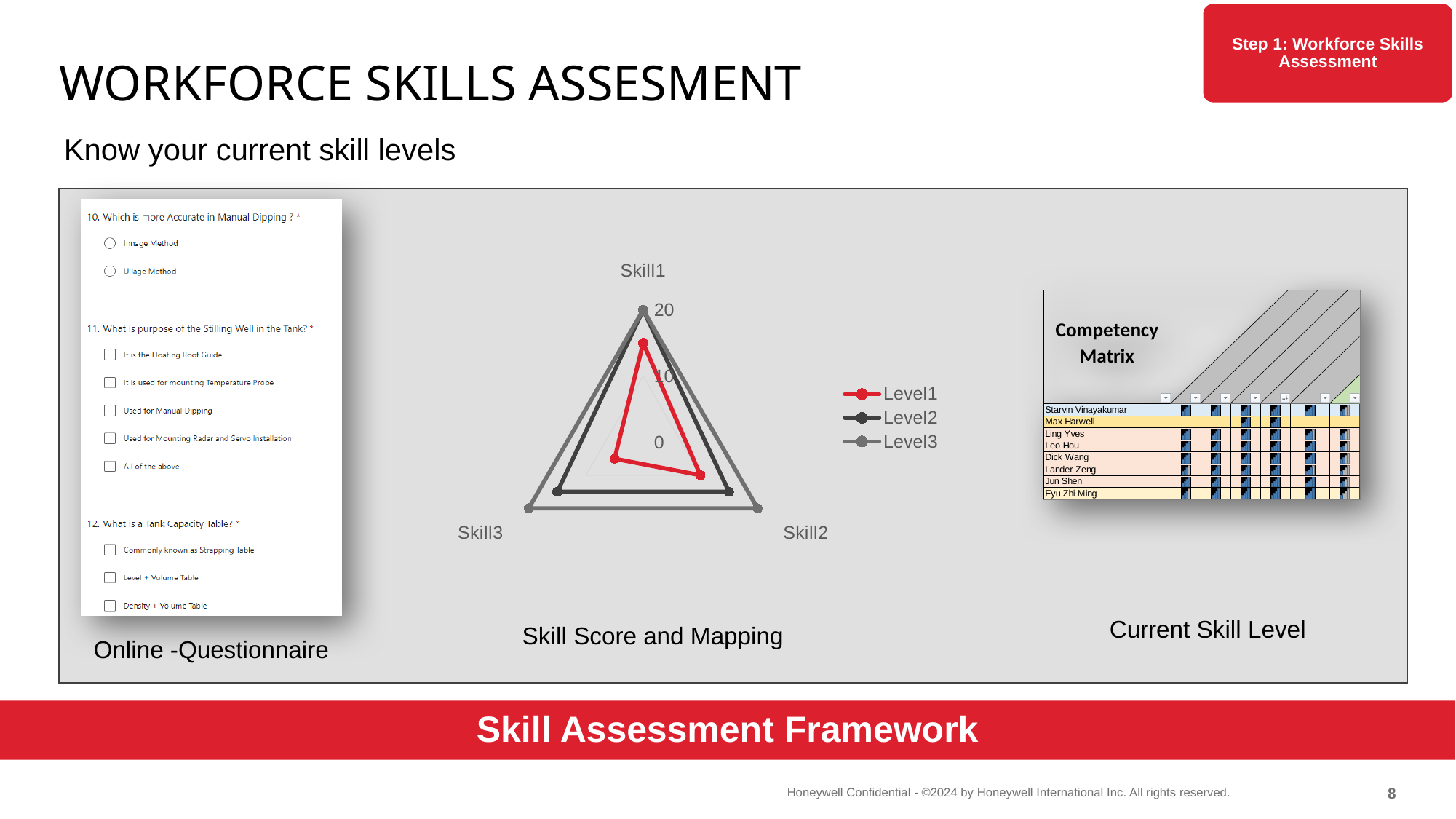
What are the names of the series in the radar chart legend? Level1, Level2, Level3 How many skill axes does the radar chart have? 3 What is the value of Level3 for Skill1 in the radar chart? 20 Is the Level1 value for Skill1 greater or less than 10? greater What kind of chart is shown under "Skill Score and Mapping"? Radar chart For the Level1 series, which skill has the lowest value? Skill3 In the Level1 series, which is larger: the value for Skill1 or the value for Skill3? Skill1 For the Level1 series, which skill has the highest value? Skill1 Is the Level2 value for Skill1 greater or less than 10? greater Is the Level1 value for Skill3 greater or less than 10? less Which series in the radar chart is drawn in red? Level1 How many series does the legend of the radar chart list? 3